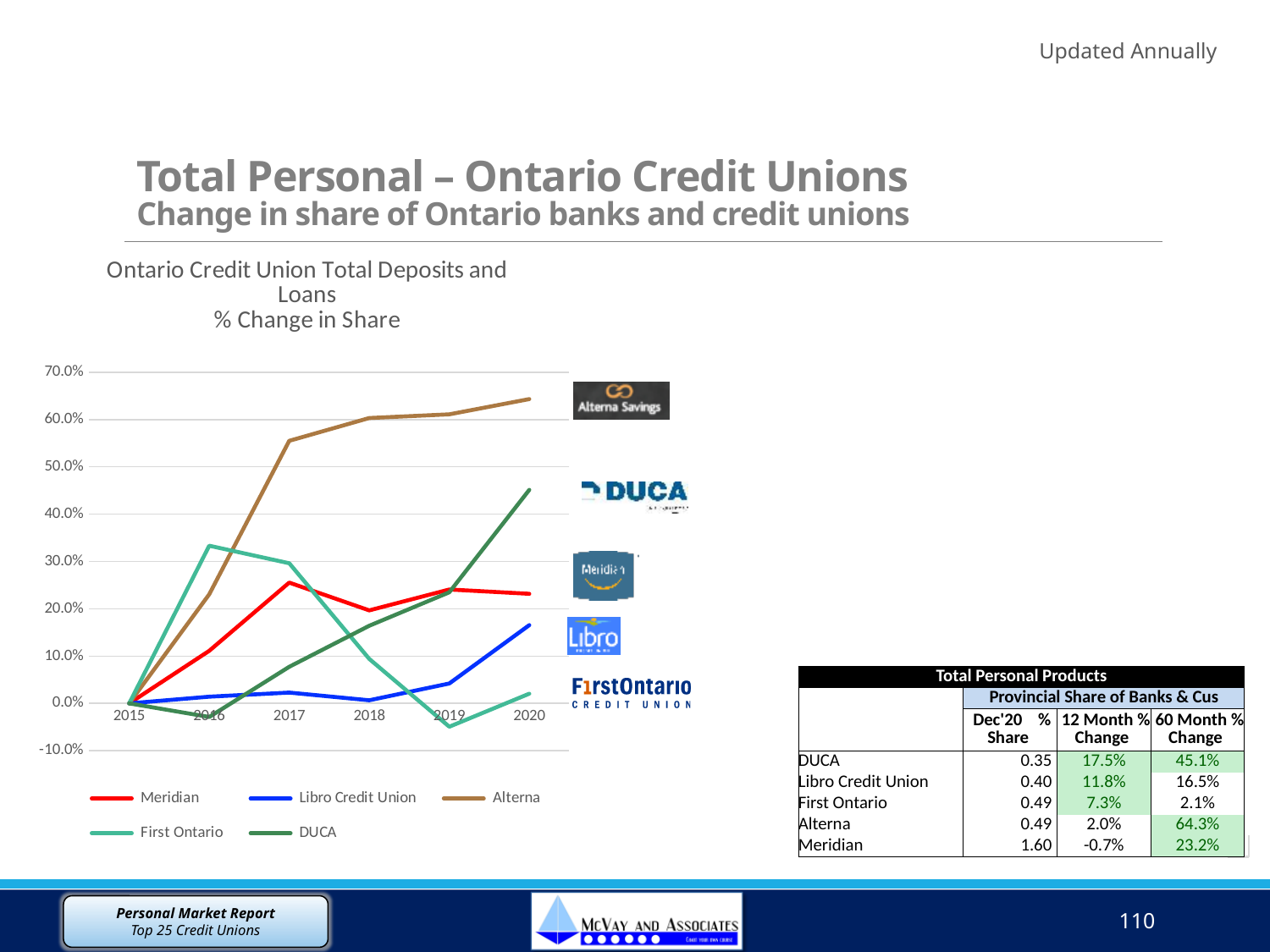
How many series does the chart legend list? 5 Which credit union has the lowest % change in share in 2020? First Ontario How many years are shown along the x axis of the chart? 6 Is the value for DUCA in 2020 greater or less than 40.0%? greater Is the value for Meridian in 2020 greater or less than 20.0%? greater In 2017, which is larger: the value for Alterna or the value for Meridian? Alterna Is the value for Alterna in 2020 greater or less than 60.0%? greater In 2016, which is larger: the value for First Ontario or the value for Alterna? First Ontario Which credit union has the highest % change in share in 2020? Alterna Which series is drawn in red on the chart? Meridian What type of chart is shown on the slide? Line chart Does the Alterna line rise or fall from 2015 to 2020? Rise